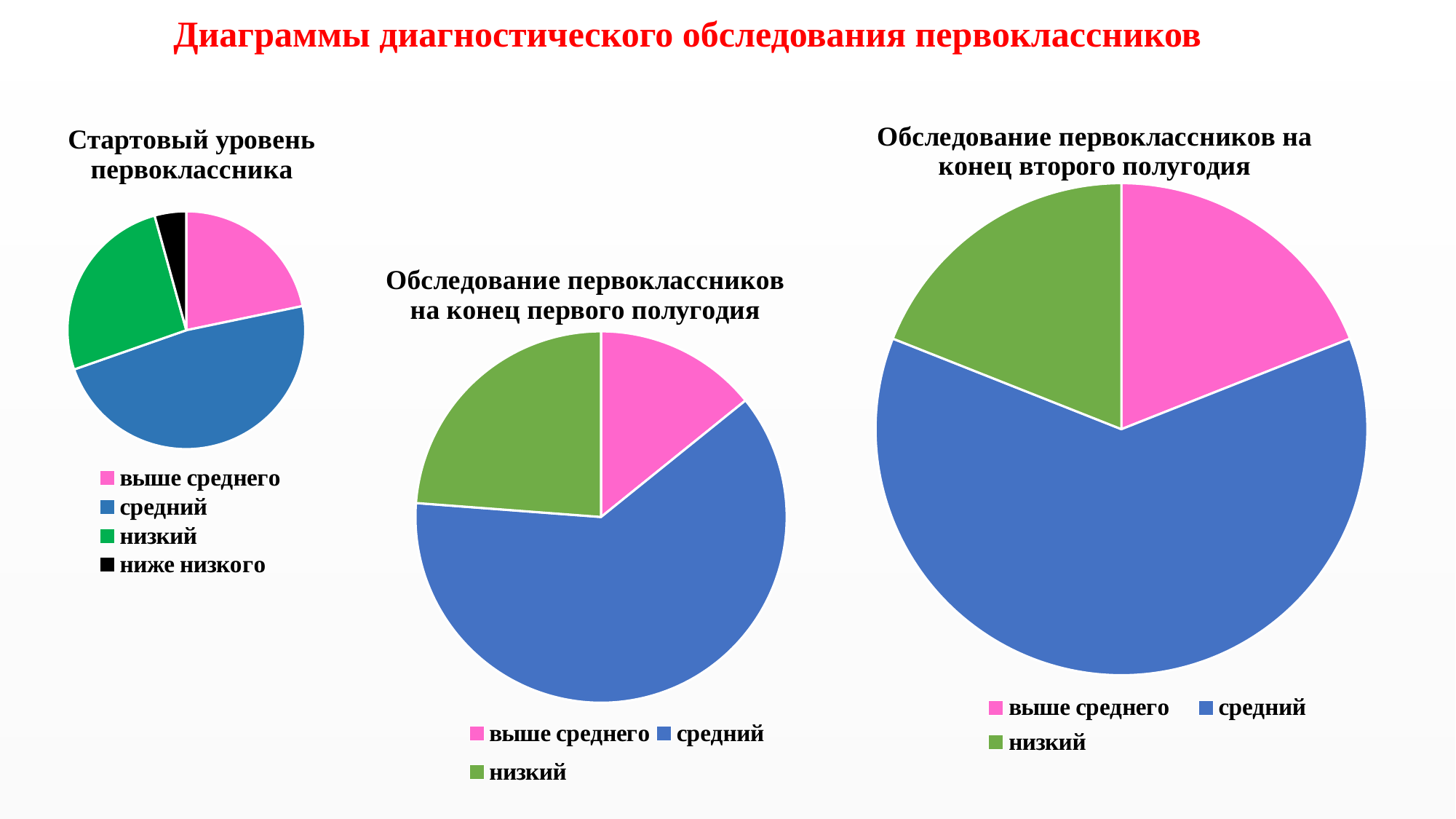
Which legend entry appears in the chart "Стартовый уровень первоклассника" but not in the other two charts? ниже низкого In the chart "Обследование первоклассников на конец первого полугодия", which slice is larger: средний or низкий? средний What kind of chart is "Стартовый уровень первоклассника"? pie chart How many slices does the pie chart "Обследование первоклассников на конец второго полугодия" have? 3 How many slices does the pie chart "Стартовый уровень первоклассника" have? 4 In the chart "Обследование первоклассников на конец второго полугодия", which category has the largest slice? средний In the chart "Обследование первоклассников на конец первого полугодия", which category has the largest slice? средний In the chart "Стартовый уровень первоклассника", which colour represents the category "ниже низкого"? black In the chart "Стартовый уровень первоклассника", which category has the smallest slice? ниже низкого How many entries does the legend of "Обследование первоклассников на конец первого полугодия" list? 3 In the chart "Обследование первоклассников на конец первого полугодия", which category has the smallest slice? выше среднего In the chart "Стартовый уровень первоклассника", which category has the largest slice? средний